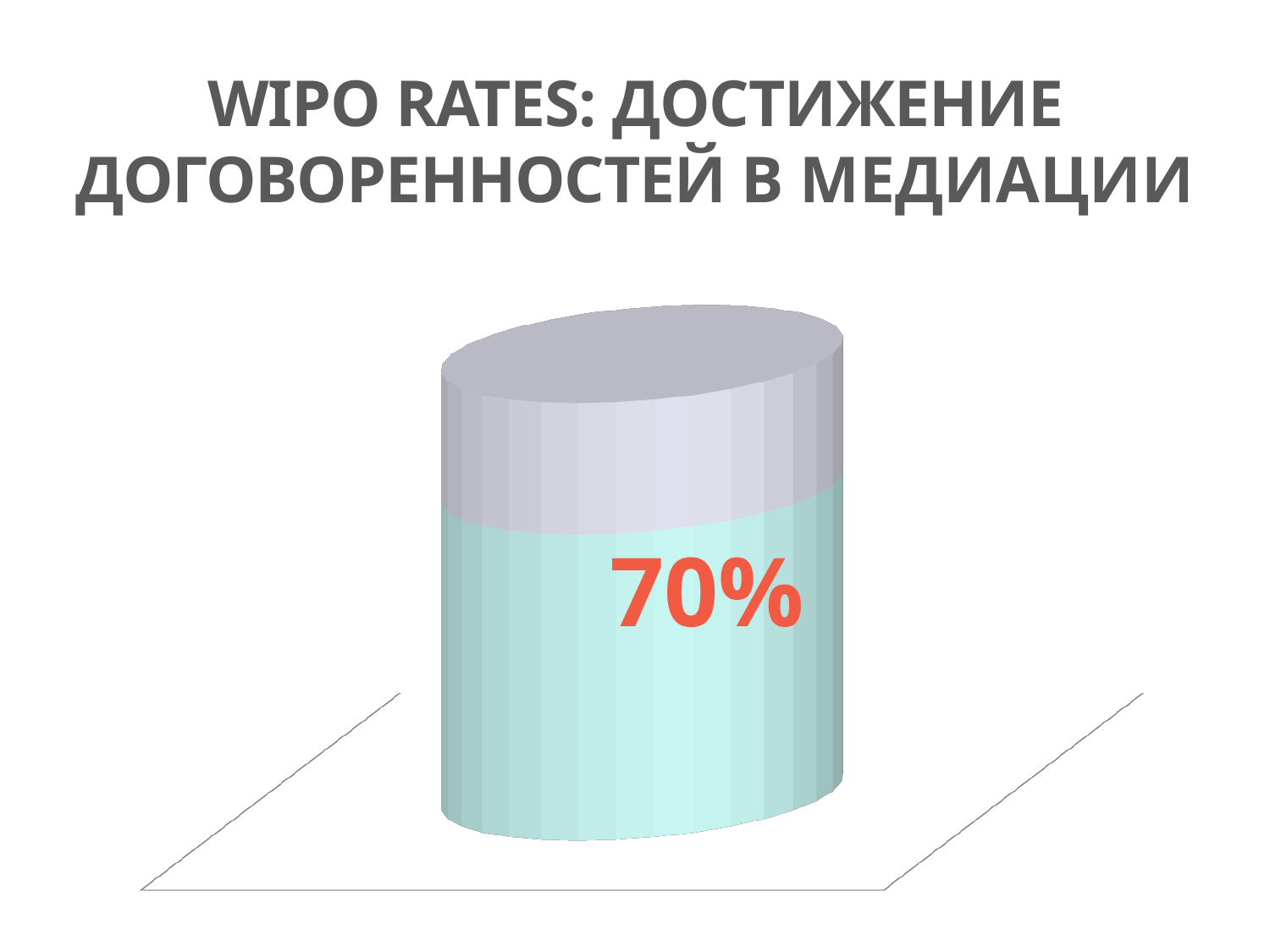
Is the value printed on the chart greater or less than 50%? greater What kind of chart is shown on the slide? bar chart How many data labels are printed on the chart? 1 What colour is the segment of the bar that carries the 70% label? light green What value is printed on the chart? 70% What is the title of the slide containing the chart? WIPO RATES: ДОСТИЖЕНИЕ ДОГОВОРЕННОСТЕЙ В МЕДИАЦИИ